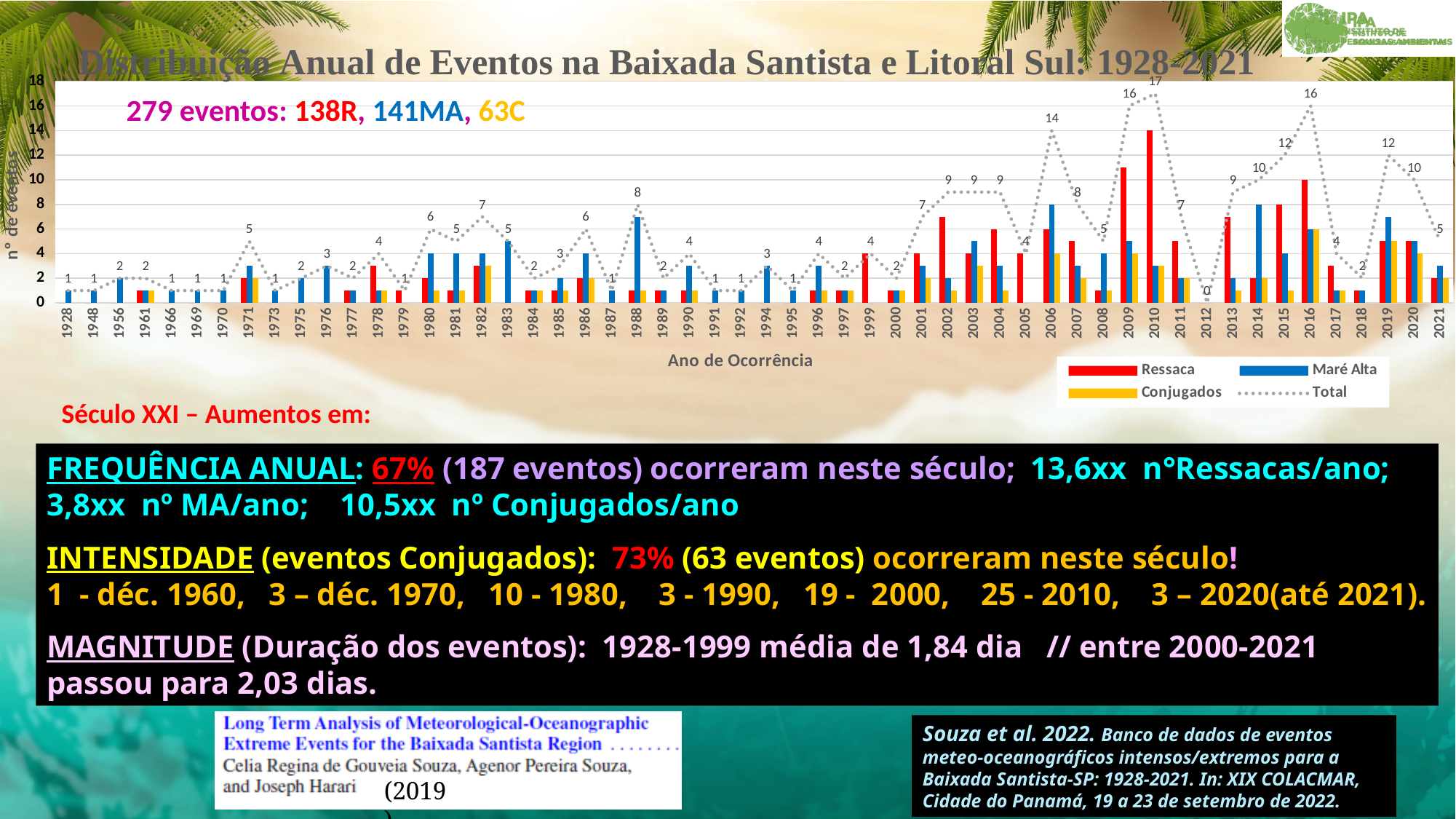
Which year has a larger Total value, 2015 or 2016? 2016 Which year has the lowest Total value on the dotted line? 2012 Is the Maré Alta value for 2006 greater or less than 6? greater How many entries does the chart legend list? 4 Is the Ressaca value for 2010 greater or less than 12? greater What is the Total value shown for 2010? 17 What is the difference between the Total values for 2006 and 2007? 6 What is the title of the x axis of the chart? Ano de Ocorrência Which year has the highest Total value on the dotted line? 2010 What kind of chart is used to show the events per year? A combination bar and line chart (bars for Ressaca, Maré Alta and Conjugados, with a dotted line for the Total) Does the Total value rise or fall from 2012 to 2016? Rise What is the Total value shown for 2006? 14